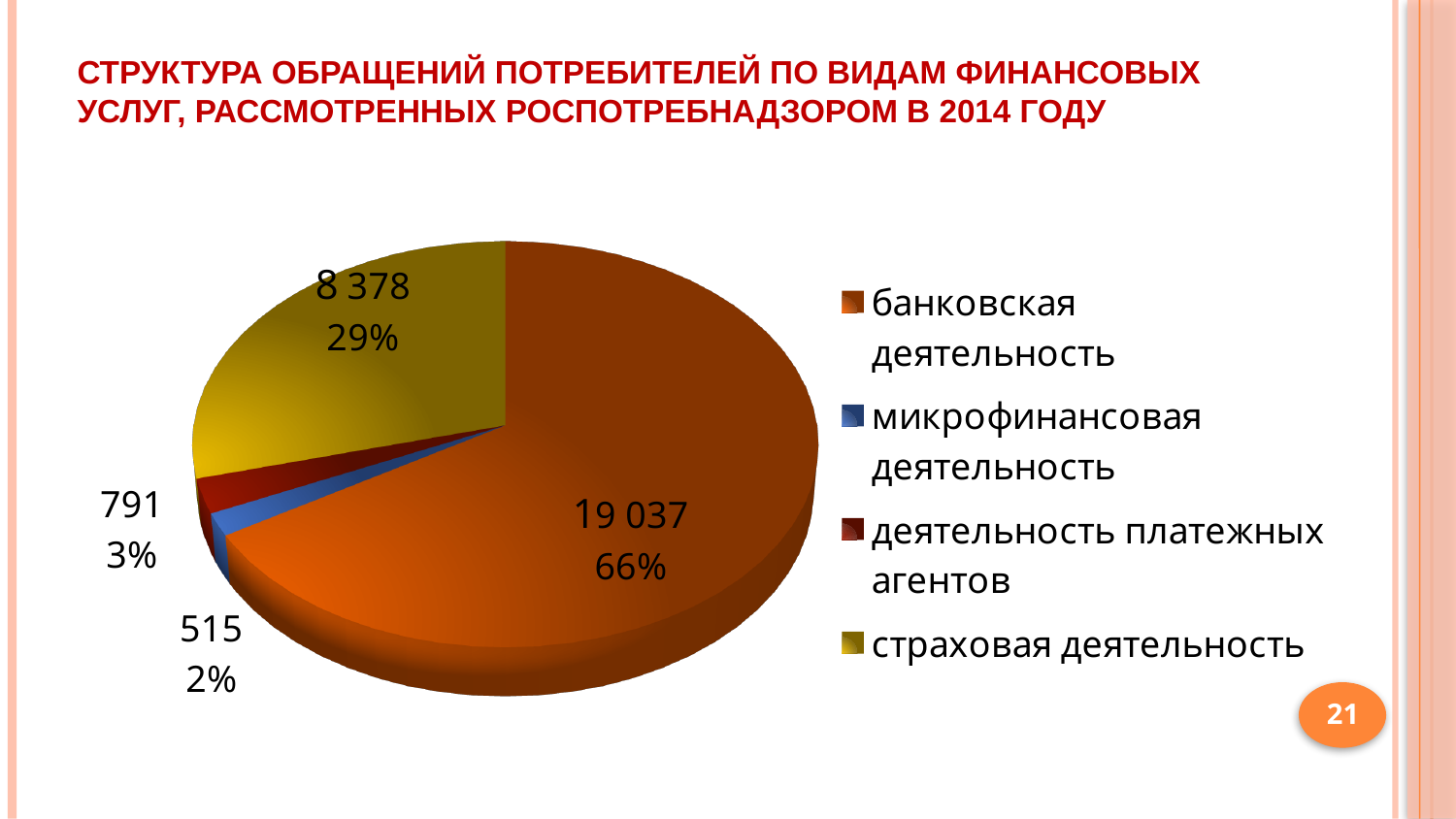
What is the value shown for страховая деятельность? 8 378 What kind of chart is shown on the slide? pie chart What is the value shown for банковская деятельность? 19 037 Which category has the smallest slice in the pie chart? микрофинансовая деятельность Which colour represents страховая деятельность in the pie chart? yellow What percentage share does страховая деятельность have in the pie chart? 29% Which category has the largest slice in the pie chart? банковская деятельность What percentage share does микрофинансовая деятельность have in the pie chart? 2% What is the value shown for деятельность платежных агентов? 791 How many slices does the pie chart have? 4 What is the difference between the values for банковская деятельность and страховая деятельность? 10 659 How many entries does the legend of the pie chart list? 4